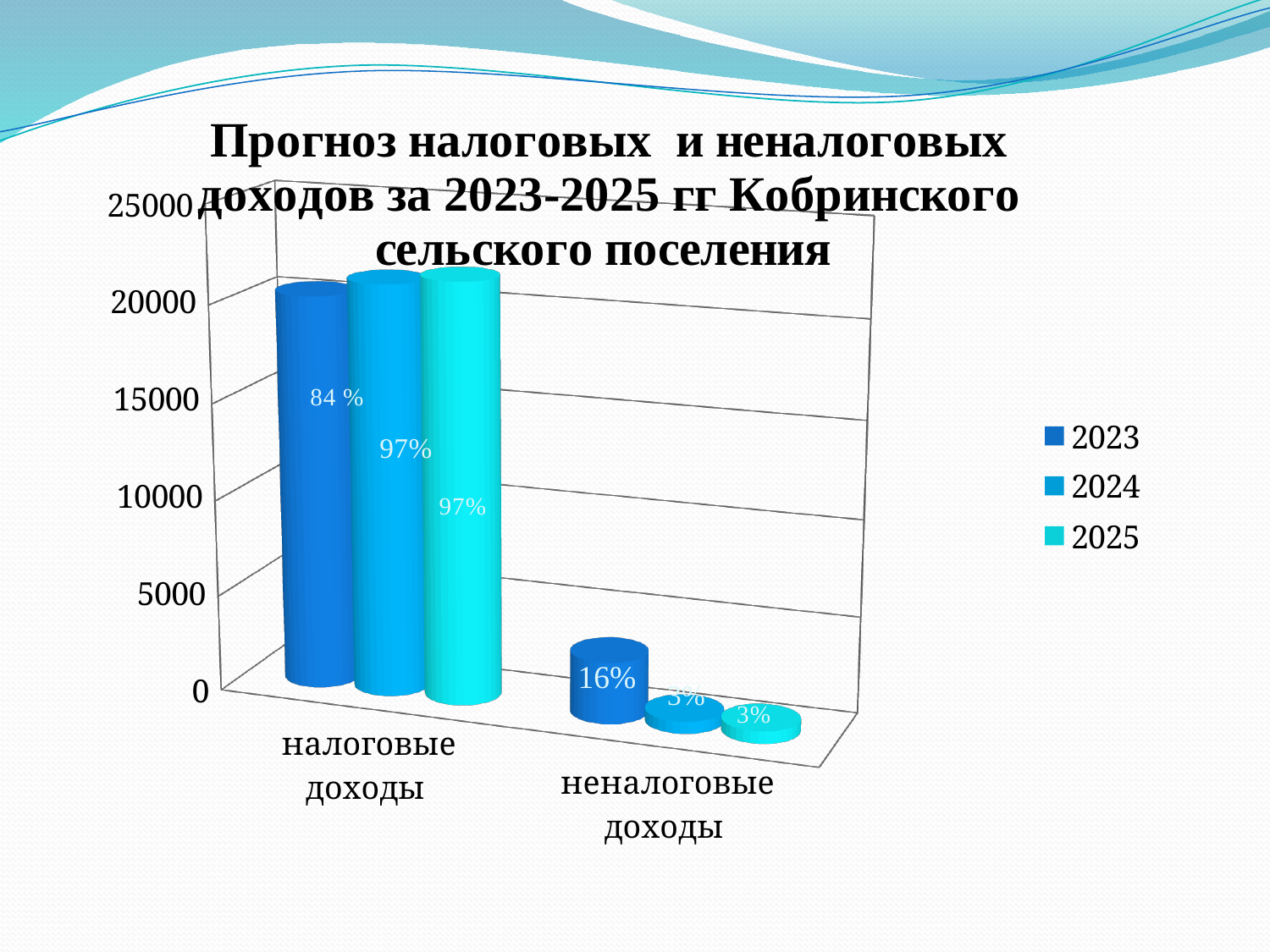
Which years are listed in the legend? 2023, 2024, 2025 How many categories are shown on the x axis? 2 Is the value for неналоговые доходы in 2023 greater or less than 5000? less Is the value for налоговые доходы in 2024 greater or less than 15000? greater What data label is shown on the 2023 bar for налоговые доходы? 84 % What data label is shown on the 2023 bar for неналоговые доходы? 16% What kind of chart is shown on the slide? bar chart What data label is shown on the 2025 bar for налоговые доходы? 97% Which category has the taller bars, налоговые доходы or неналоговые доходы? налоговые доходы What data label is shown on the 2025 bar for неналоговые доходы? 3% What data label is shown on the 2024 bar for налоговые доходы? 97% How many series does the legend list? 3